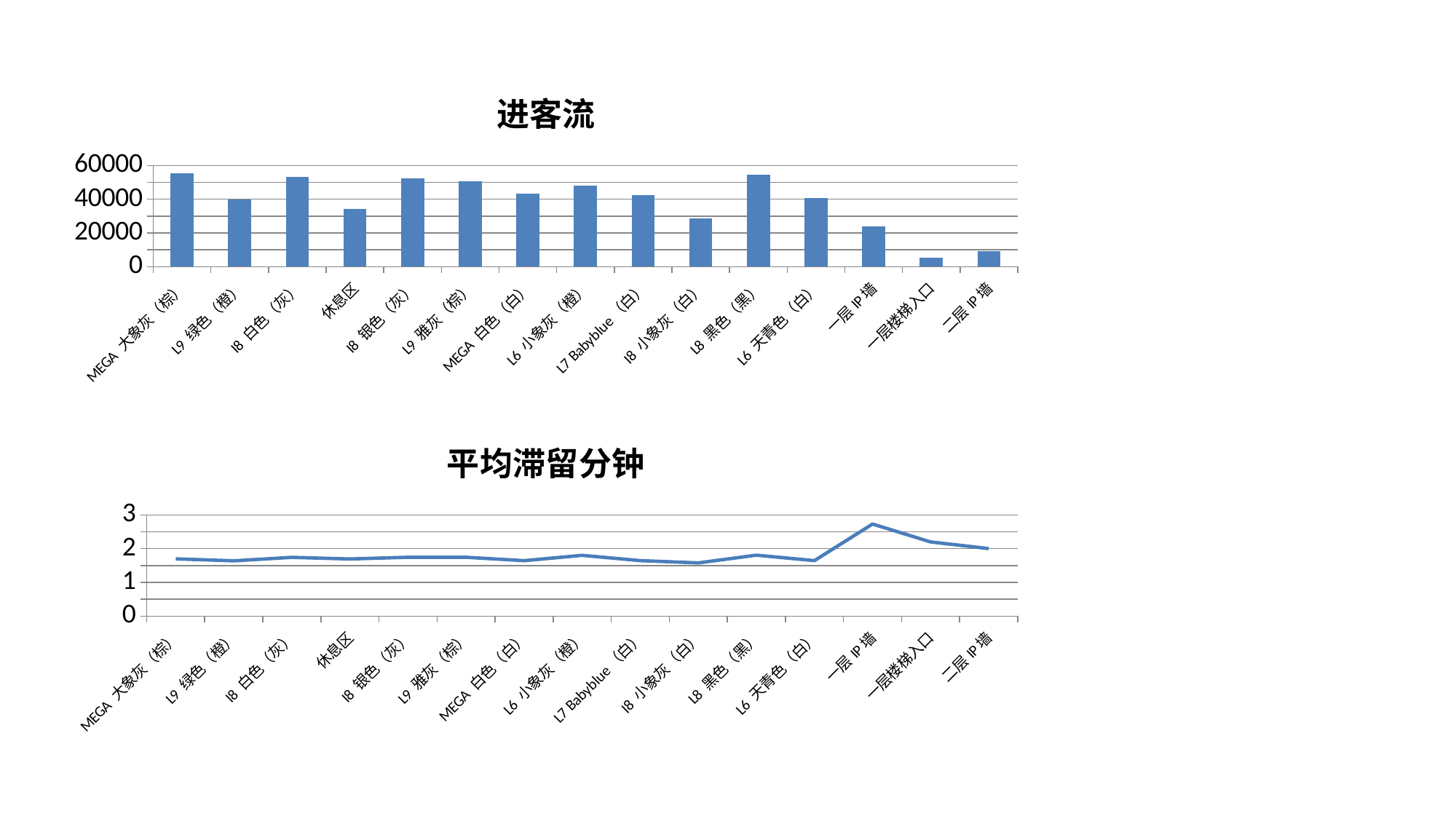
In the 平均滞留分钟 chart, is the value for MEGA 大象灰（棕） greater or less than 2? less What is the title of the bottom chart? 平均滞留分钟 In the 平均滞留分钟 chart, which category has the highest value? 一层 IP 墙 In the 平均滞留分钟 chart, is the value for 一层 IP 墙 greater or less than 2? greater In the 进客流 chart, which is larger, the value for 休息区 or the value for I8 银色（灰）? I8 银色（灰） In the 进客流 chart, which category has the lowest value? 一层楼梯入口 In the 进客流 chart, which is larger, the value for 一层楼梯入口 or the value for 二层 IP 墙? 二层 IP 墙 In the 进客流 chart, how many categories are shown on the x axis? 15 In the 进客流 chart, is the value for I8 小象灰（白） greater or less than 40000? less What type of chart is the top chart titled 进客流? bar chart What type of chart is the bottom chart titled 平均滞留分钟? line chart